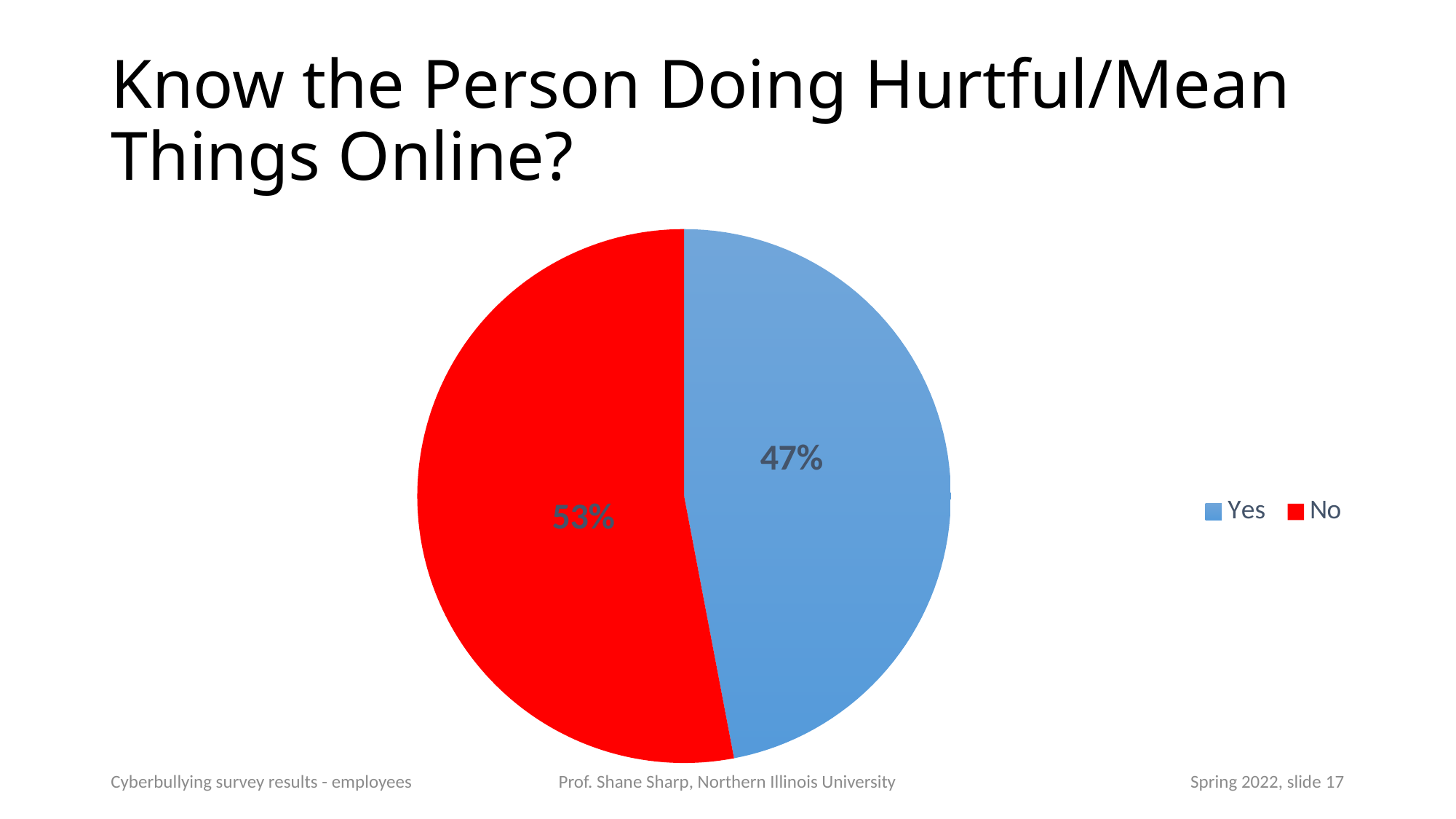
Which is larger, the "Yes" slice or the "No" slice? No Which slice of the pie is the largest? No What is the title of the slide containing the pie chart? Know the Person Doing Hurtful/Mean Things Online? What is the difference in percentage points between the "No" slice and the "Yes" slice? 6 What colour is the "Yes" slice in the pie chart? blue What percentage of the pie is labelled "Yes"? 47% How many slices does the pie chart have? 2 What percentage of the pie is labelled "No"? 53% Which slice of the pie is the smallest? Yes What kind of chart is shown on the slide? pie chart What share of the pie does the "No" slice represent? 53% How many entries does the legend list? 2